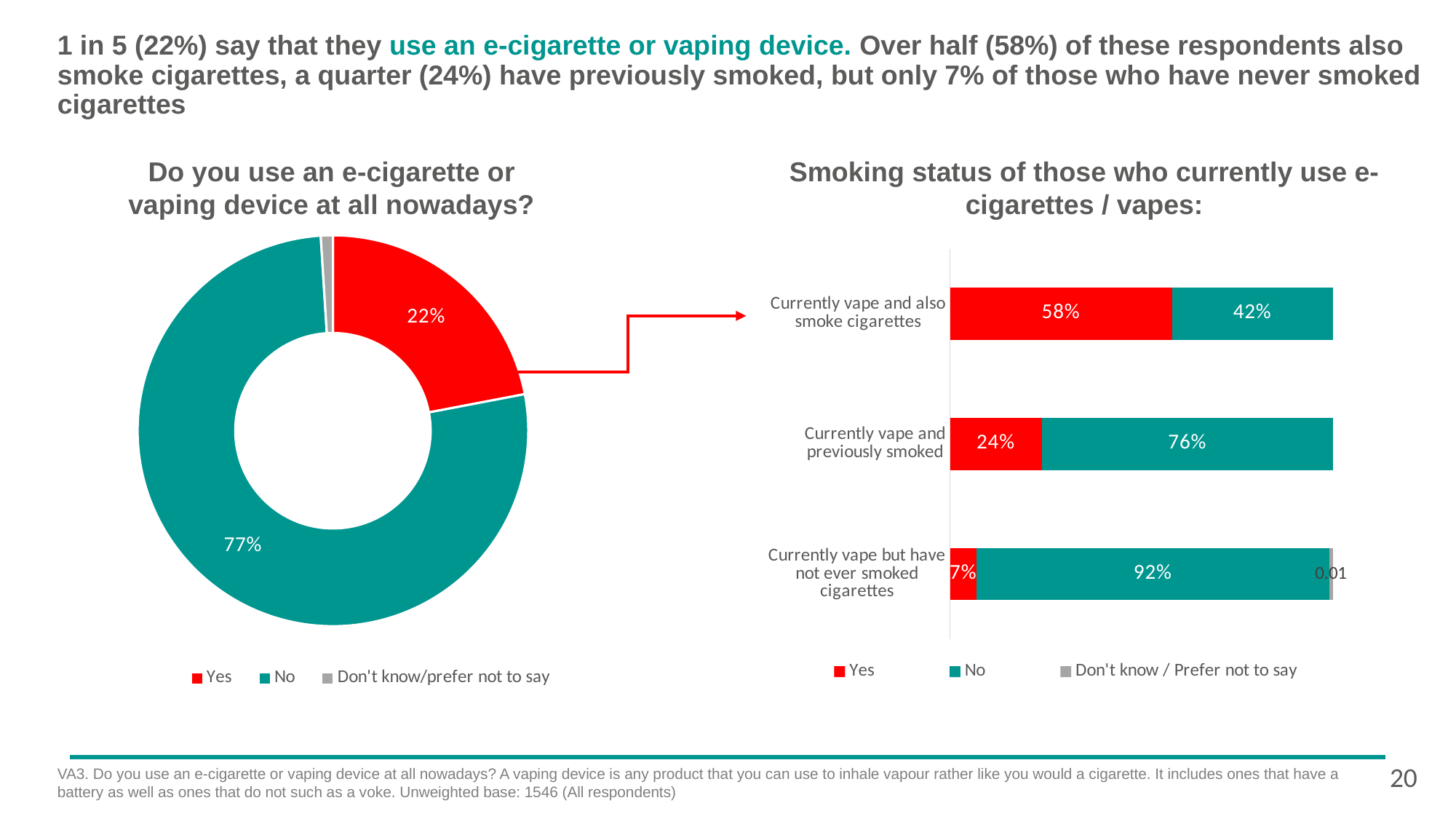
In the right chart 'Smoking status of those who currently use e-cigarettes / vapes', what is the Yes value for 'Currently vape but have not ever smoked cigarettes'? 7% What kind of chart is the left chart 'Do you use an e-cigarette or vaping device at all nowadays?'? Donut (pie) chart In the left chart 'Do you use an e-cigarette or vaping device at all nowadays?', what percentage answered No? 77% What kind of chart is the right chart 'Smoking status of those who currently use e-cigarettes / vapes'? Stacked bar chart In the right chart 'Smoking status of those who currently use e-cigarettes / vapes', which category has the lowest Yes value? Currently vape but have not ever smoked cigarettes In the left chart 'Do you use an e-cigarette or vaping device at all nowadays?', what percentage answered Yes? 22% In the right chart 'Smoking status of those who currently use e-cigarettes / vapes', what is the No value for 'Currently vape and previously smoked'? 76% In the right chart 'Smoking status of those who currently use e-cigarettes / vapes', what is the Yes value for 'Currently vape and also smoke cigarettes'? 58% How many entries does the legend of the left chart list? 3 In the right chart 'Smoking status of those who currently use e-cigarettes / vapes', which category has the highest Yes value? Currently vape and also smoke cigarettes In the left chart, which response has the largest share: Yes or No? No In the right chart 'Smoking status of those who currently use e-cigarettes / vapes', what is the difference between the Yes values for 'Currently vape and also smoke cigarettes' and 'Currently vape and previously smoked'? 34 percentage points